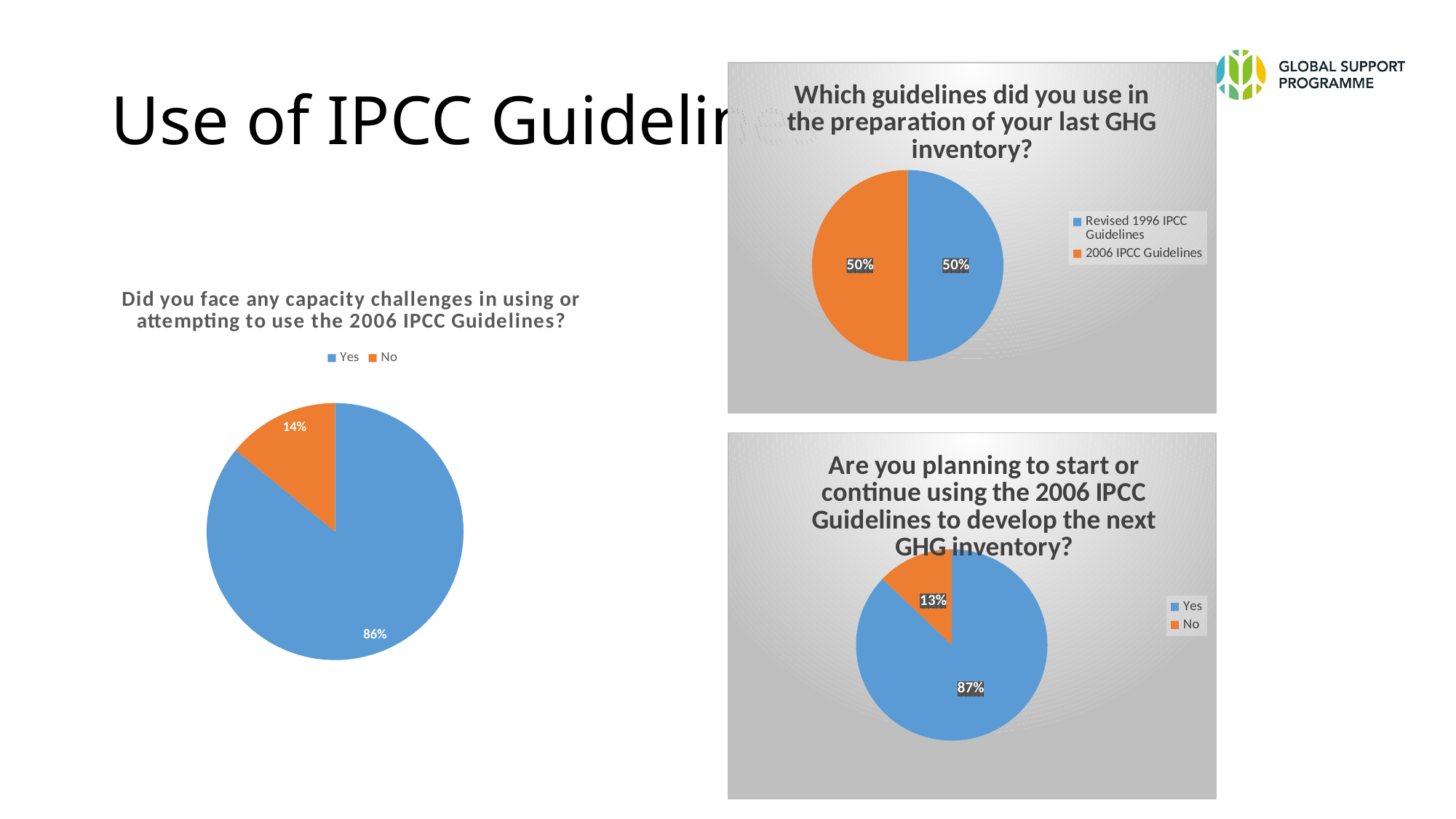
In the chart titled "Which guidelines did you use in the preparation of your last GHG inventory?", which legend entry is shown in blue? Revised 1996 IPCC Guidelines What kind of chart is the chart titled "Which guidelines did you use in the preparation of your last GHG inventory?"? Pie chart In the chart titled "Are you planning to start or continue using the 2006 IPCC Guidelines to develop the next GHG inventory?", which is larger, Yes or No? Yes In the chart titled "Did you face any capacity challenges in using or attempting to use the 2006 IPCC Guidelines?", which response has the largest slice? Yes In the chart titled "Which guidelines did you use in the preparation of your last GHG inventory?", what share used the 2006 IPCC Guidelines? 50% In the chart titled "Did you face any capacity challenges in using or attempting to use the 2006 IPCC Guidelines?", what is the difference in percentage points between Yes and No? 72 How many slices does the chart titled "Which guidelines did you use in the preparation of your last GHG inventory?" have? 2 In the chart titled "Are you planning to start or continue using the 2006 IPCC Guidelines to develop the next GHG inventory?", what share answered Yes? 87% In the chart titled "Did you face any capacity challenges in using or attempting to use the 2006 IPCC Guidelines?", what share of respondents answered No? 14% In the chart titled "Are you planning to start or continue using the 2006 IPCC Guidelines to develop the next GHG inventory?", what share answered No? 13% In the chart titled "Are you planning to start or continue using the 2006 IPCC Guidelines to develop the next GHG inventory?", which response has the smallest slice? No In the chart titled "Did you face any capacity challenges in using or attempting to use the 2006 IPCC Guidelines?", what share of respondents answered Yes? 86%